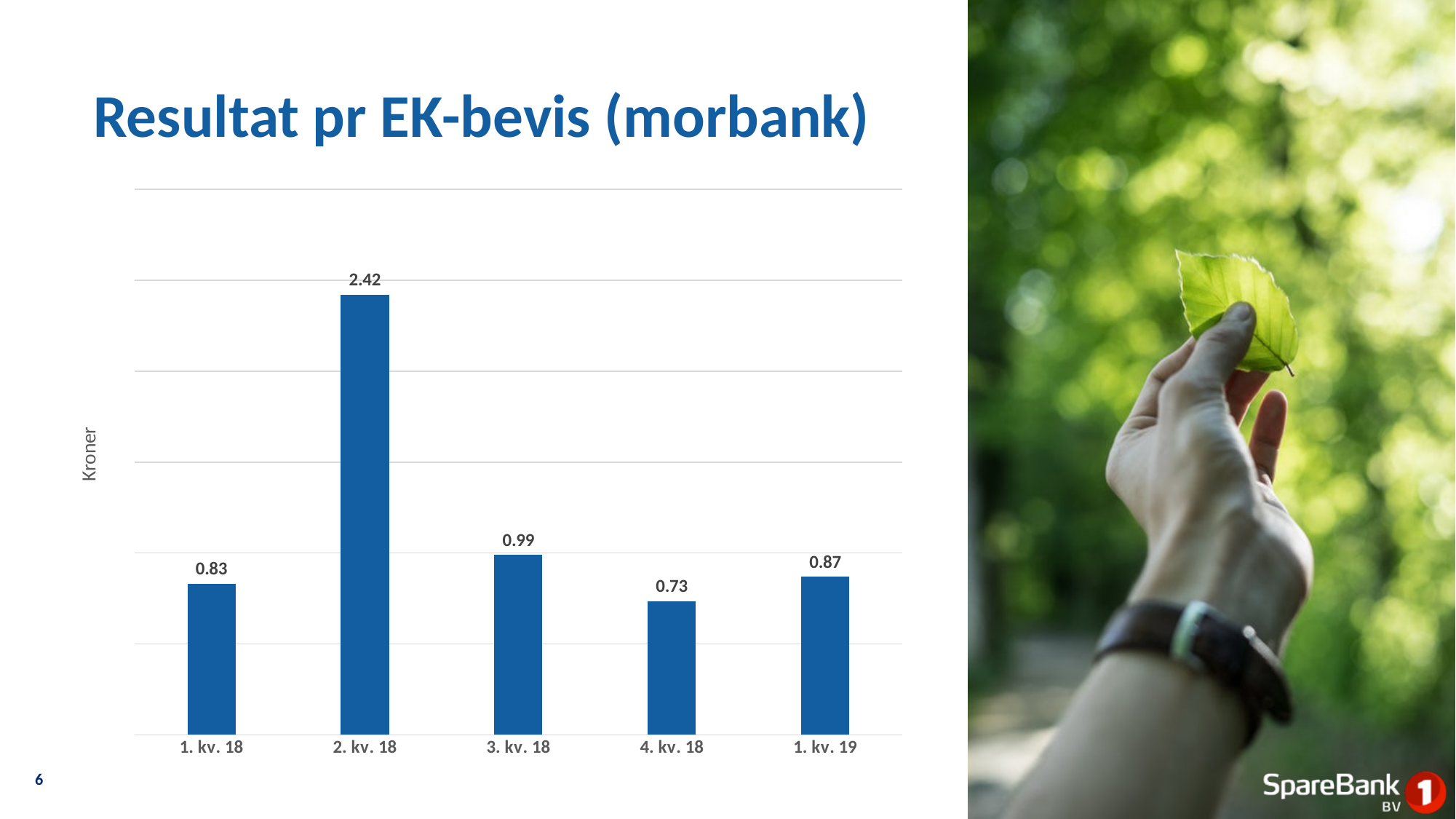
What kind of chart is shown on the slide? Bar chart What is the title of the chart? Resultat pr EK-bevis (morbank) Which is larger, the value for 3. kv. 18 or the value for 1. kv. 19? 3. kv. 18 Which quarter has the highest value? 2. kv. 18 What is the value for 2. kv. 18? 2.42 What is the value for 1. kv. 19? 0.87 What is the label on the vertical axis? Kroner What is the value for 4. kv. 18? 0.73 How many quarters are shown on the chart? 5 Which quarter has the lowest value? 4. kv. 18 What is the difference between the values for 1. kv. 19 and 1. kv. 18? 0.04 What is the difference between the values for 2. kv. 18 and 3. kv. 18? 1.43